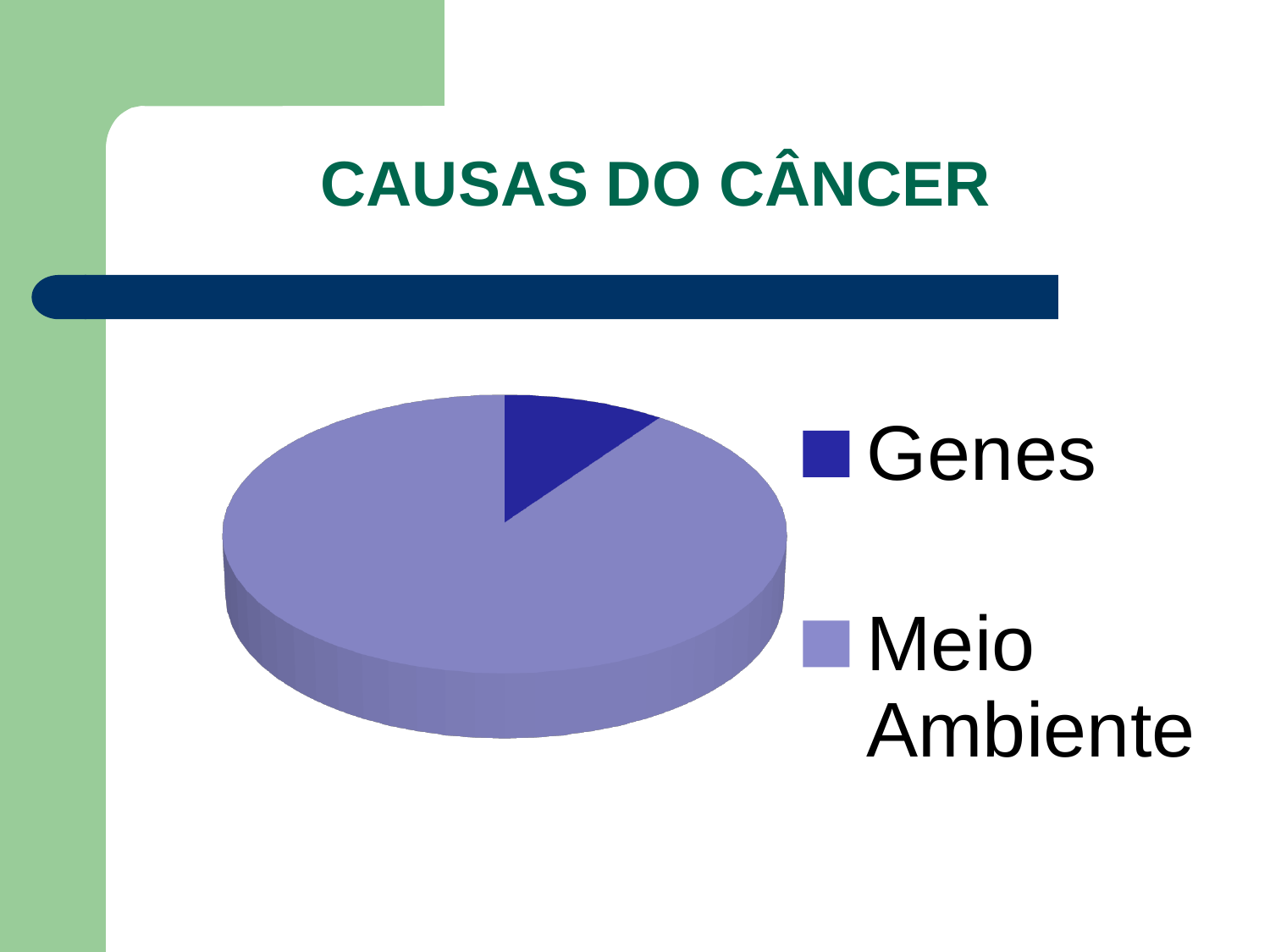
What is the title of the slide containing the pie chart? CAUSAS DO CÂNCER Which category has the largest slice of the pie? Meio Ambiente How many slices does the pie chart have? 2 Which category is shown in dark blue in the pie chart? Genes Which category has the smallest slice of the pie? Genes What kind of chart is shown on the slide? pie chart How many entries does the legend list? 2 Which slice is larger, Genes or Meio Ambiente? Meio Ambiente